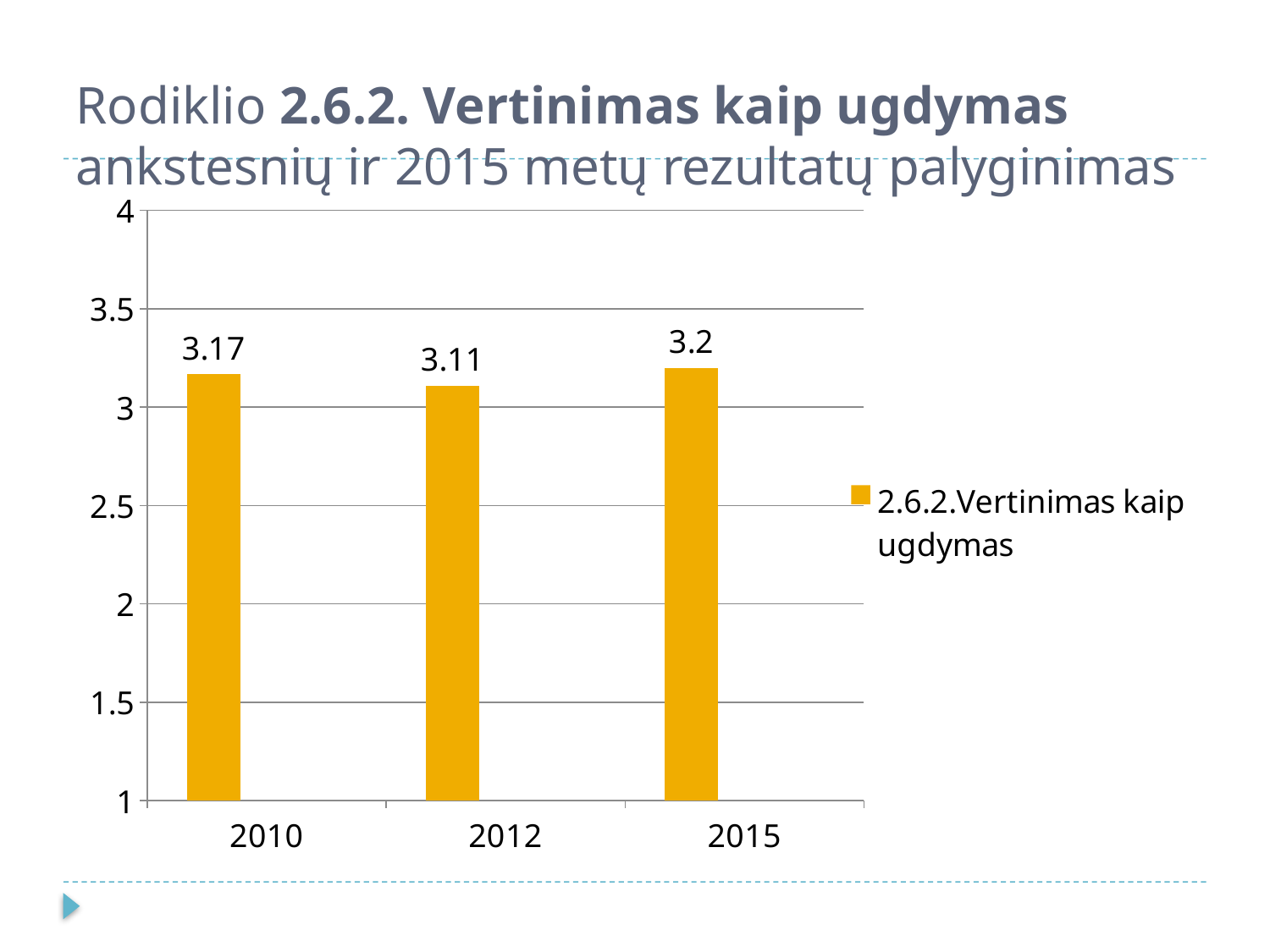
Which year has the highest value? 2015 Which is larger, the value for 2010 or the value for 2015? 2015 How many years are shown on the x axis? 3 Is the value for 2012 greater or less than 3.5? less Which year has the lowest value? 2012 What is the difference between the values for 2010 and 2012? 0.06 What is the value for 2015? 3.2 What is the difference between the values for 2015 and 2012? 0.09 What kind of chart is shown on the slide? bar chart What is the value for 2010? 3.17 What is the value for 2012? 3.11 How many series does the legend list? 1